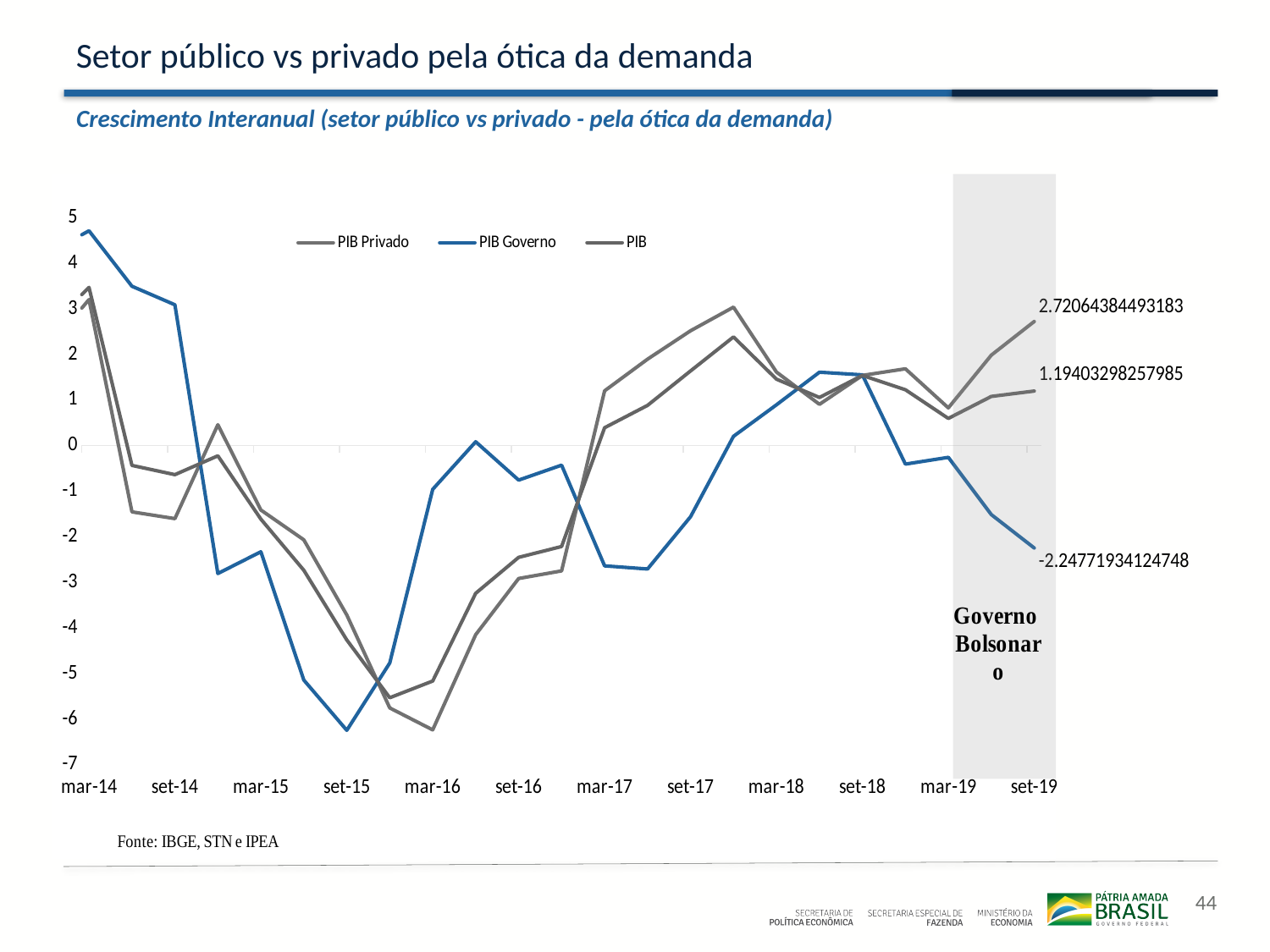
Is the value for PIB Governo at set-15 greater or less than -5? less What is the value of PIB Governo at set-19? -2.24771934124748 What is the difference between the two labeled values 2.72064384493183 and 1.19403298257985 at set-19? 1.52661086235198 Is the value for PIB Governo at mar-14 greater or less than 4? greater Which series has the lowest value at set-19? PIB Governo Does the PIB Governo line rise or fall between mar-14 and set-15? fall At mar-14, which series has the higher value: PIB Governo or PIB Privado? PIB Governo What is the difference between the highest labeled value at set-19 (2.72064384493183) and the PIB Governo value at set-19 (-2.24771934124748)? 4.96836318617931 How many series does the chart legend list? 3 What type of chart is shown on the slide? line chart What is the highest value labeled at set-19 on the chart? 2.72064384493183 What label appears in the shaded region at the right of the chart? Governo Bolsonaro